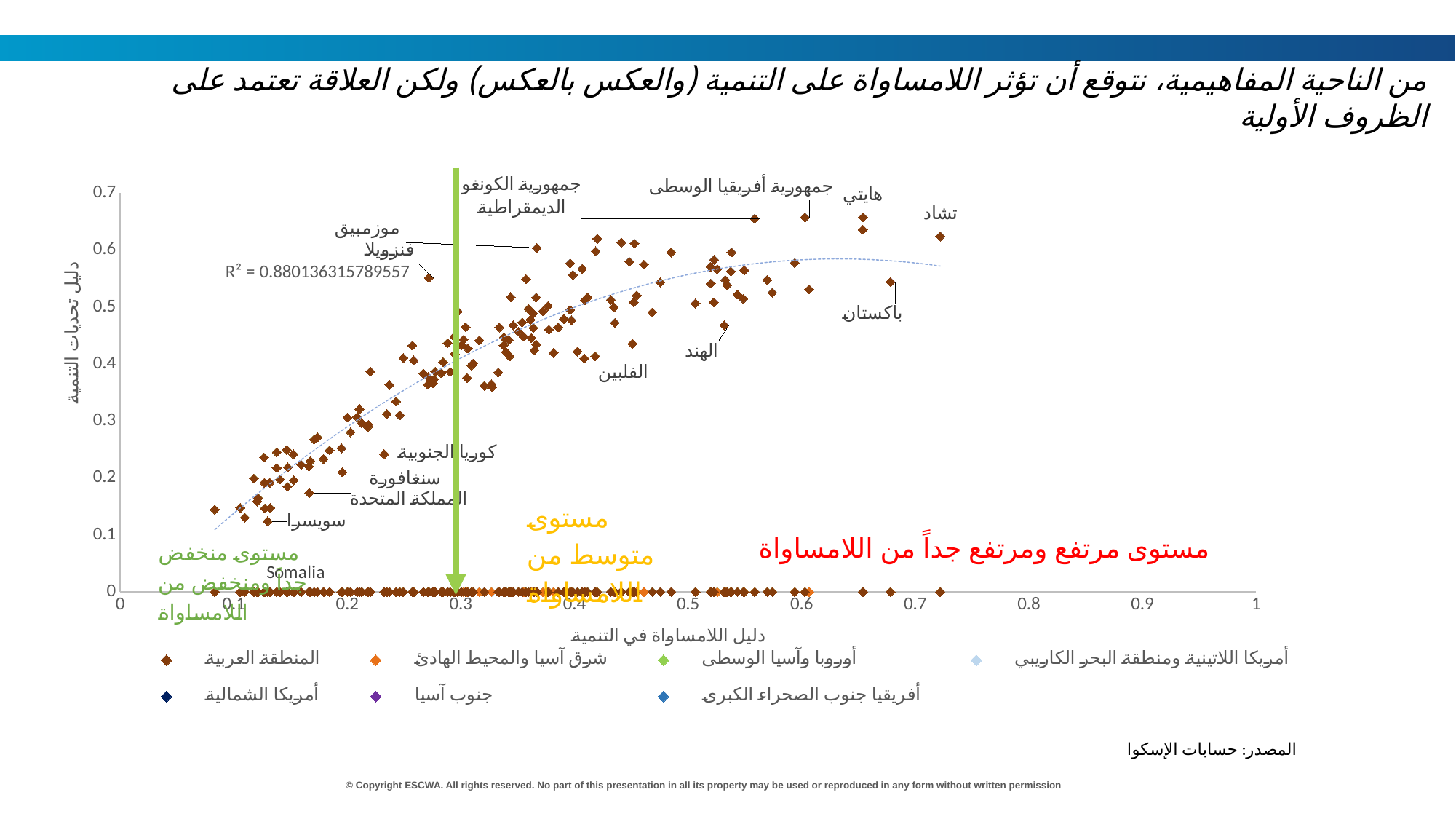
Is the horizontal-axis value for كوريا الجنوبية greater or less than 0.3? less How many series does the legend list? 7 Which has the higher vertical-axis value, هايتي or الهند? هايتي Is the vertical-axis value for باكستان greater or less than 0.5? greater Do the plotted values generally rise or fall as the horizontal-axis value increases? rise Is the vertical-axis value for سويسرا greater or less than 0.2? less What is the R² value printed on the chart? R² = 0.880136315789557 What kind of chart is shown on the slide? scatter chart What is the label of the vertical axis? دليل تحديات التنمية Which has the higher vertical-axis value, تشاد or سويسرا? تشاد What is the label of the horizontal axis? دليل اللامساواة في التنمية